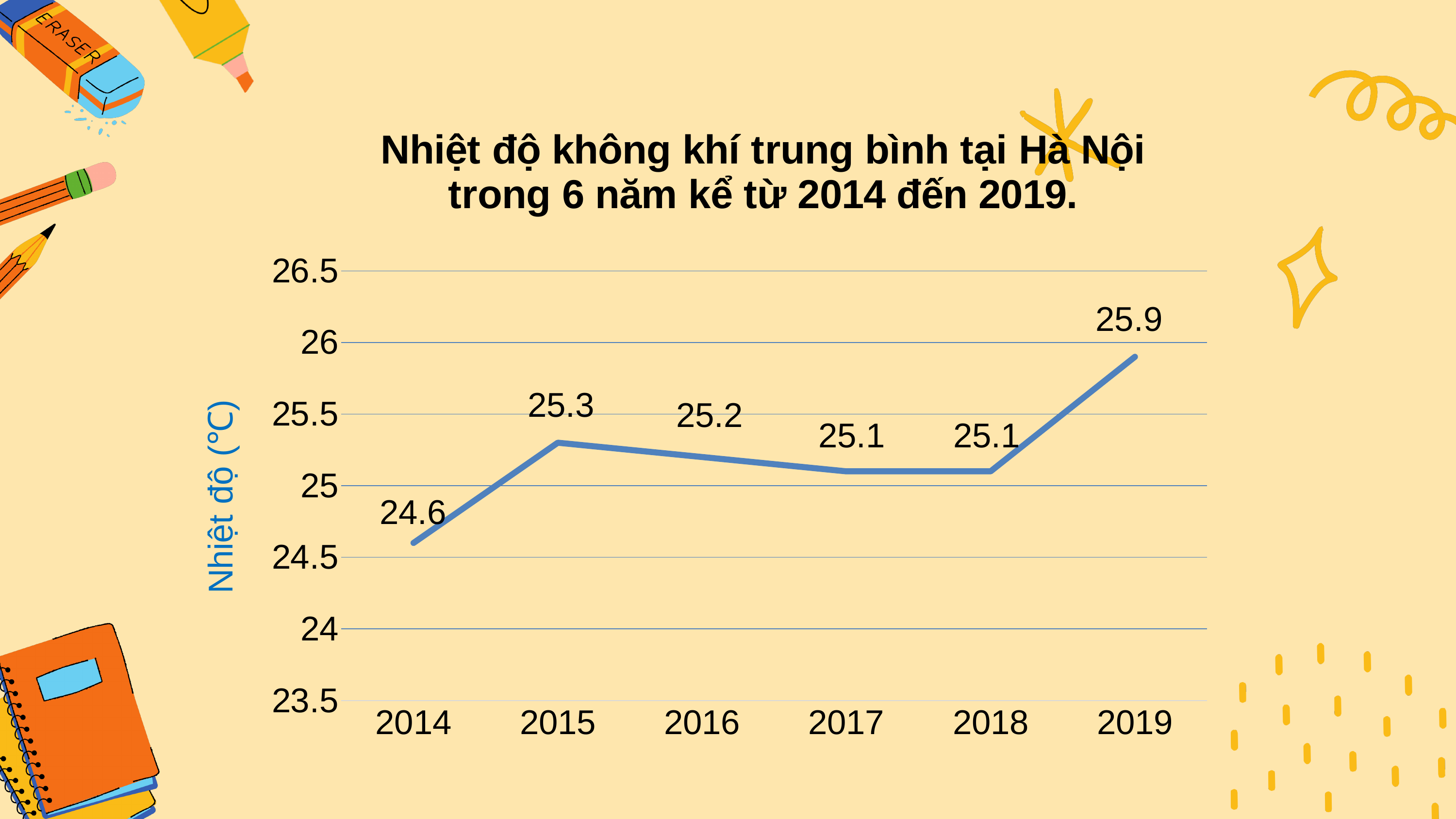
Which year has the highest average temperature? 2019 What is the label of the vertical axis? Nhiệt độ (°C) Which year has the lowest average temperature? 2014 What was the average air temperature in Hanoi in 2019? 25.9 What kind of chart is shown on the slide? line chart How many years are plotted on the chart? 6 Which is larger, the value for 2015 or the value for 2018? 2015 What was the average air temperature in Hanoi in 2014? 24.6 What is the difference between the temperature in 2019 and the temperature in 2014? 1.3 What value is shown for 2016? 25.2 Is the value for 2014 greater or less than 25? less What is the difference between the values for 2015 and 2016? 0.1